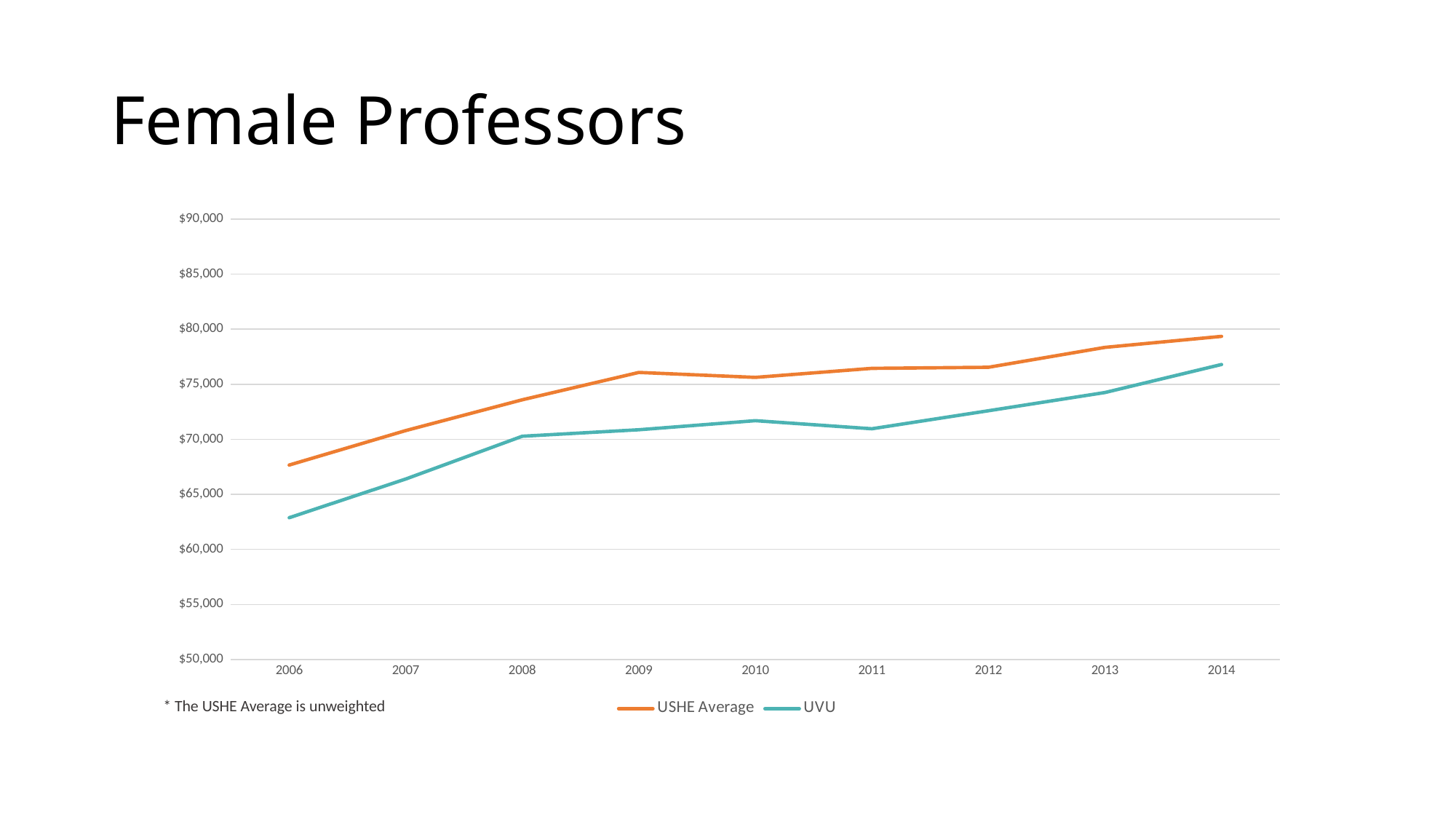
Do the UVU values generally rise or fall from 2006 to 2014? rise In which year is the UVU series at its lowest? 2006 Which colour is used for the UVU line? teal In 2010, which series has the larger value, USHE Average or UVU? USHE Average Is the USHE Average value for 2006 greater or less than $65,000? greater Is the UVU value for 2011 greater or less than $70,000? greater In which year is the USHE Average series at its highest? 2014 How many series does the legend list? 2 Is the UVU value for 2006 greater or less than $65,000? less What kind of chart is shown on the slide? line chart How many years are shown on the x axis? 9